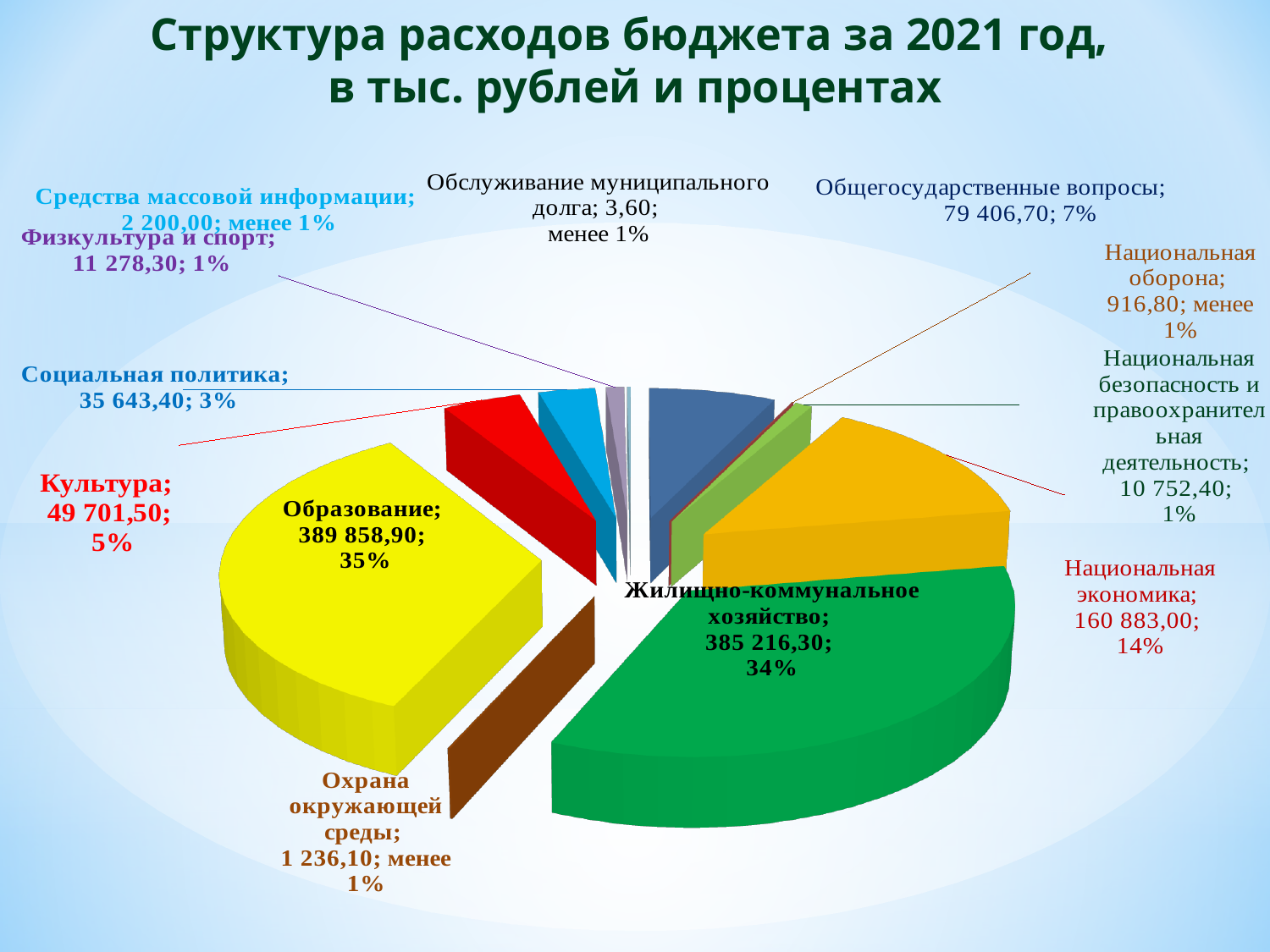
Which category has the largest value? Образование What is the value for Национальная экономика? 160 883,00 What share of the pie does Жилищно-коммунальное хозяйство represent? 34% What is the value for Общегосударственные вопросы? 79 406,70 Which is larger, the value for Культура or the value for Социальная политика? Культура What share of the pie does Культура represent? 5% How many categories are shown in the pie chart? 12 What is the difference between the values for Образование and Жилищно-коммунальное хозяйство? 4 642,60 What is the value for Образование? 389 858,90 What kind of chart is shown on the slide? Pie chart Which category has the smallest value? Обслуживание муниципального долга What is the value for Обслуживание муниципального долга? 3,60